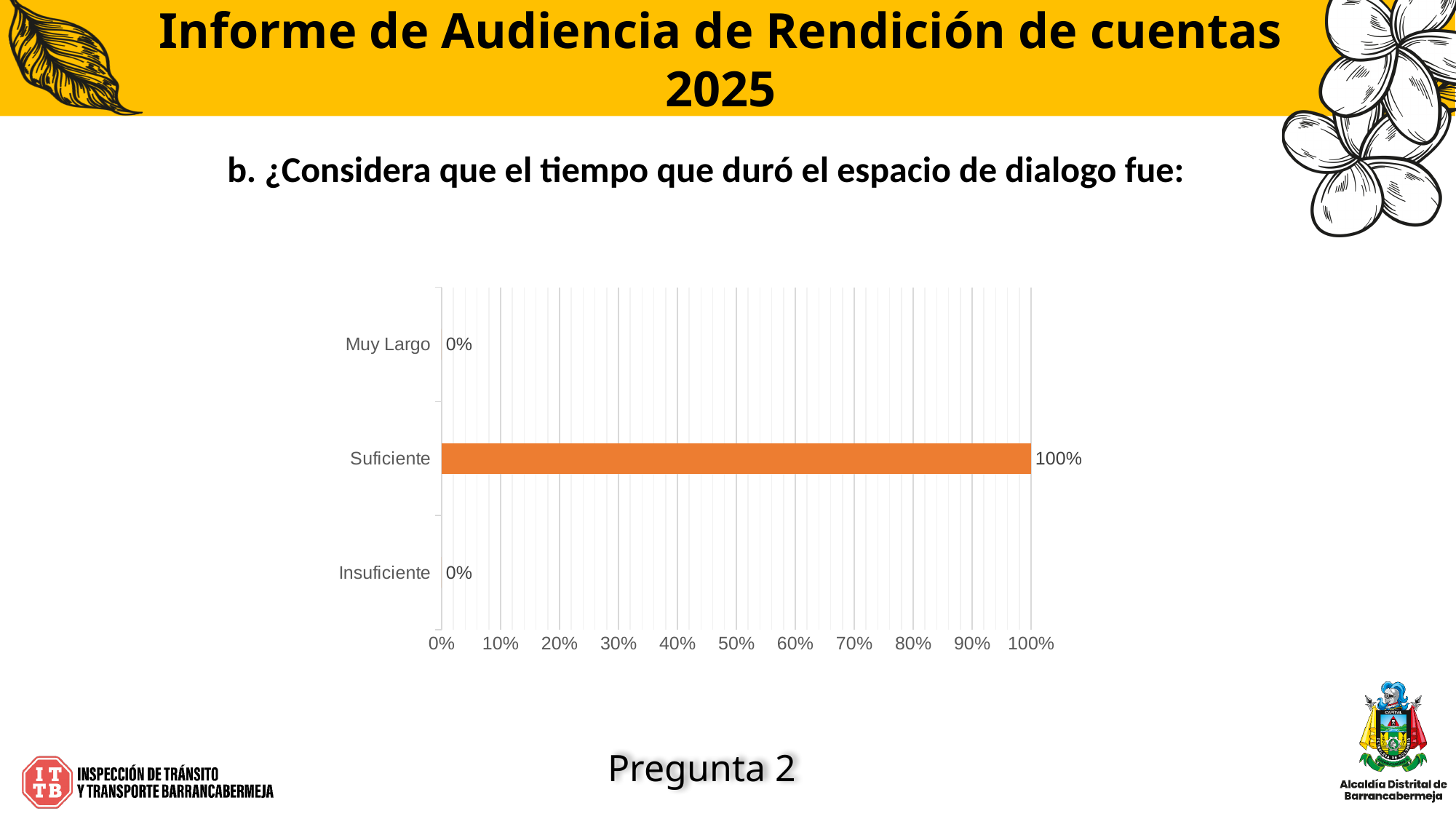
Which is larger, the value for Suficiente or the value for Muy Largo? Suficiente What is the value for Muy Largo? 0% What is the value for Insuficiente? 0% What kind of chart is shown on the slide? bar chart What colour is the bar for Suficiente? orange Is the value for Suficiente greater or less than 50%? greater What is the highest value shown on the x axis? 100% How many categories are shown on the chart? 3 Which category has the highest value? Suficiente What is the value for Suficiente? 100% What is the difference between the values for Suficiente and Insuficiente? 100%